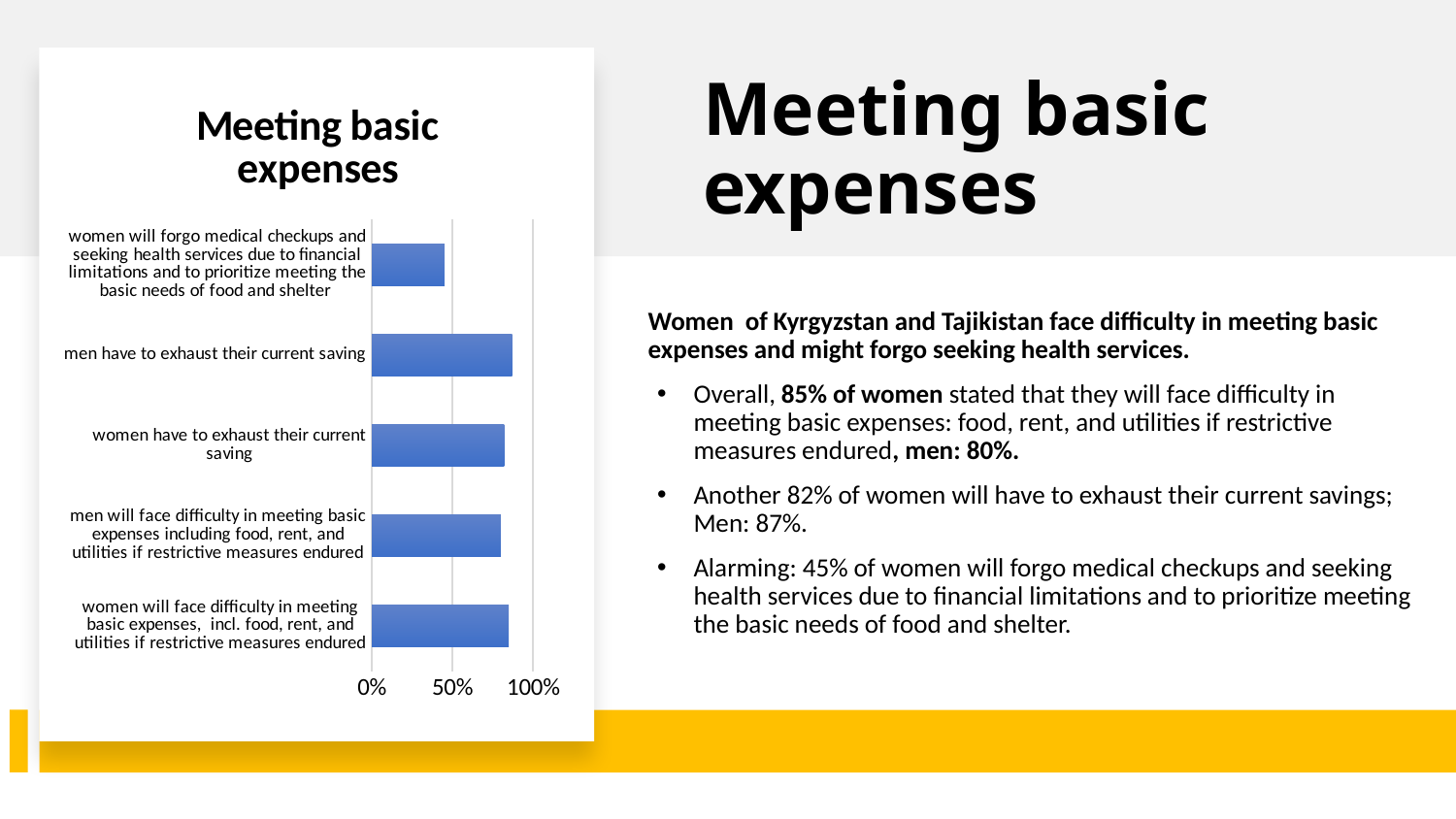
Is the value for 'men will face difficulty in meeting basic expenses including food, rent, and utilities if restrictive measures endured' greater or less than 100%? less Which is larger: the value for 'men have to exhaust their current saving' or the value for 'women will forgo medical checkups and seeking health services due to financial limitations and to prioritize meeting the basic needs of food and shelter'? men have to exhaust their current saving Is the value for 'men have to exhaust their current saving' greater or less than 50%? greater Is the value for 'women will face difficulty in meeting basic expenses, incl. food, rent, and utilities if restrictive measures endured' greater or less than 50%? greater How many bars in the chart extend beyond the 50% mark? 4 How many categories (bars) does the chart show? 5 What is the title of the chart? Meeting basic expenses What is the highest tick label shown on the value axis of the chart? 100% Which is larger: the value for 'men have to exhaust their current saving' or the value for 'men will face difficulty in meeting basic expenses including food, rent, and utilities if restrictive measures endured'? men have to exhaust their current saving Which category has the lowest value in the chart? women will forgo medical checkups and seeking health services due to financial limitations and to prioritize meeting the basic needs of food and shelter What kind of chart is shown on the slide? bar chart